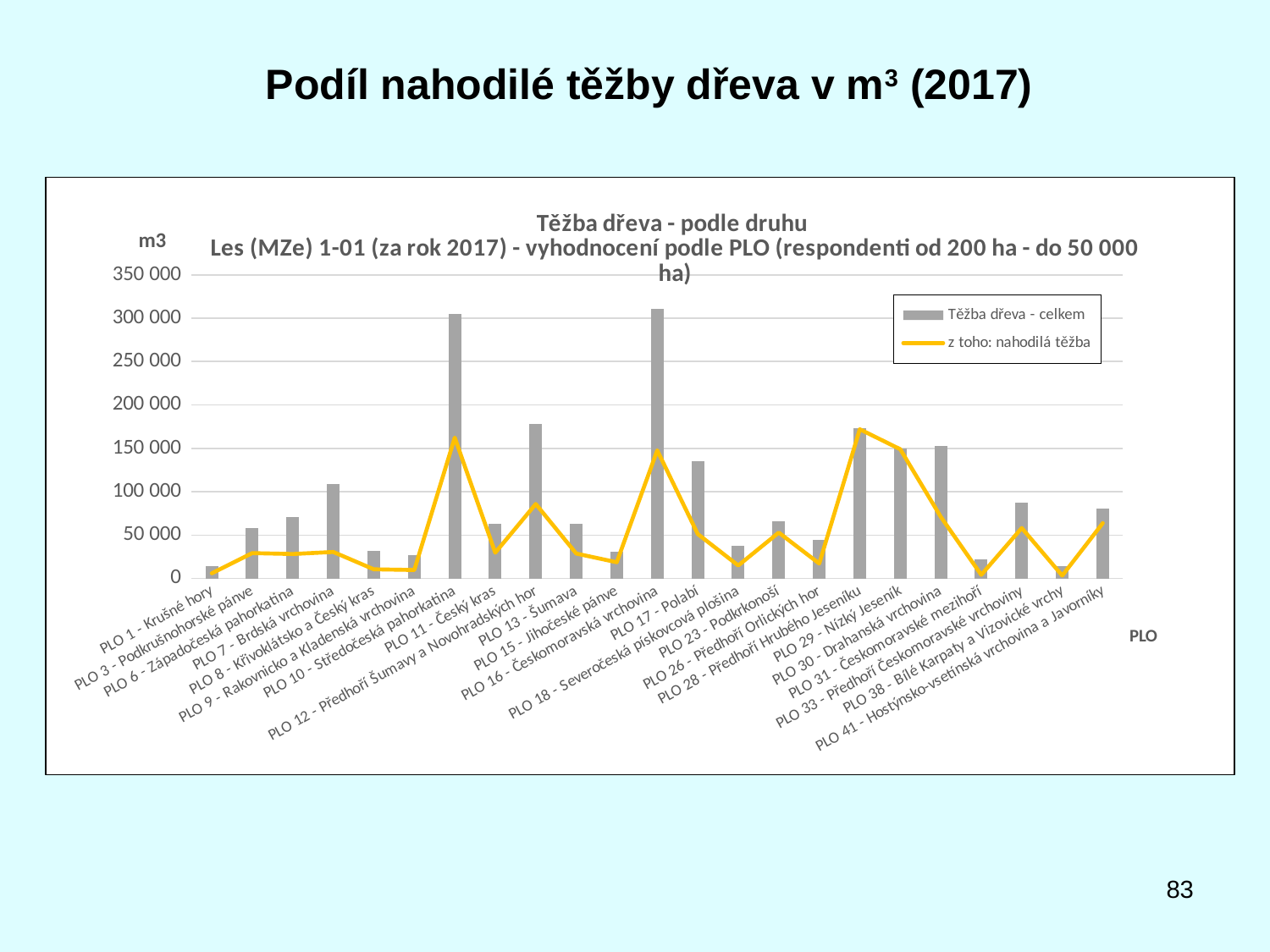
How many PLO categories are plotted along the x axis? 23 Which has the larger Těžba dřeva - celkem value: PLO 10 - Středočeská pahorkatina or PLO 12 - Předhoří Šumavy a Novohradských hor? PLO 10 - Středočeská pahorkatina Which series is drawn as a line in the chart? z toho: nahodilá těžba Is the value of Těžba dřeva - celkem for PLO 17 - Polabí greater or less than 100 000? greater Is the value of Těžba dřeva - celkem for PLO 33 - Předhoří Českomoravské vrchoviny greater or less than 50 000? greater Is the value of Těžba dřeva - celkem for PLO 16 - Českomoravská vrchovina greater or less than 250 000? greater How many series does the chart legend list? 2 What unit is shown on the vertical axis of the chart? m3 Which has the larger Těžba dřeva - celkem value: PLO 17 - Polabí or PLO 18 - Severočeská pískovcová plošina? PLO 17 - Polabí What kind of chart is shown on the slide? bar chart with a line series